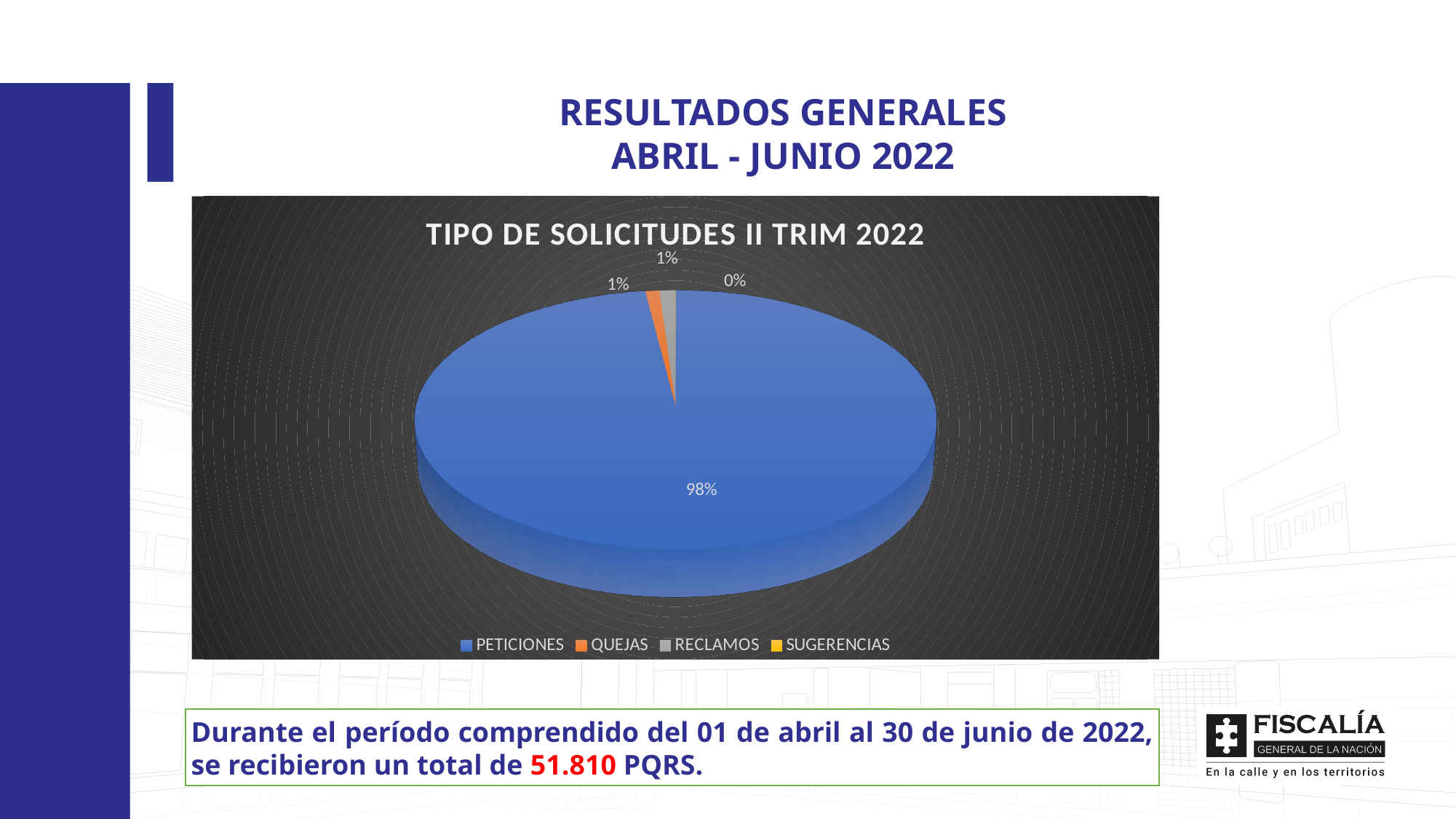
How many categories does the legend list? 4 What is the value shown for RECLAMOS? 1% Which is larger, PETICIONES or QUEJAS? PETICIONES What is the value shown for QUEJAS? 1% What type of chart is shown on the slide? pie chart What is the value shown for SUGERENCIAS? 0% What is the difference in percentage points between PETICIONES and QUEJAS? 97 Which category has the largest share of the pie? PETICIONES What colour is the PETICIONES slice? blue Which category has the smallest share of the pie? SUGERENCIAS What percentage of the pie does PETICIONES represent? 98% What is the title of the chart? TIPO DE SOLICITUDES II TRIM 2022